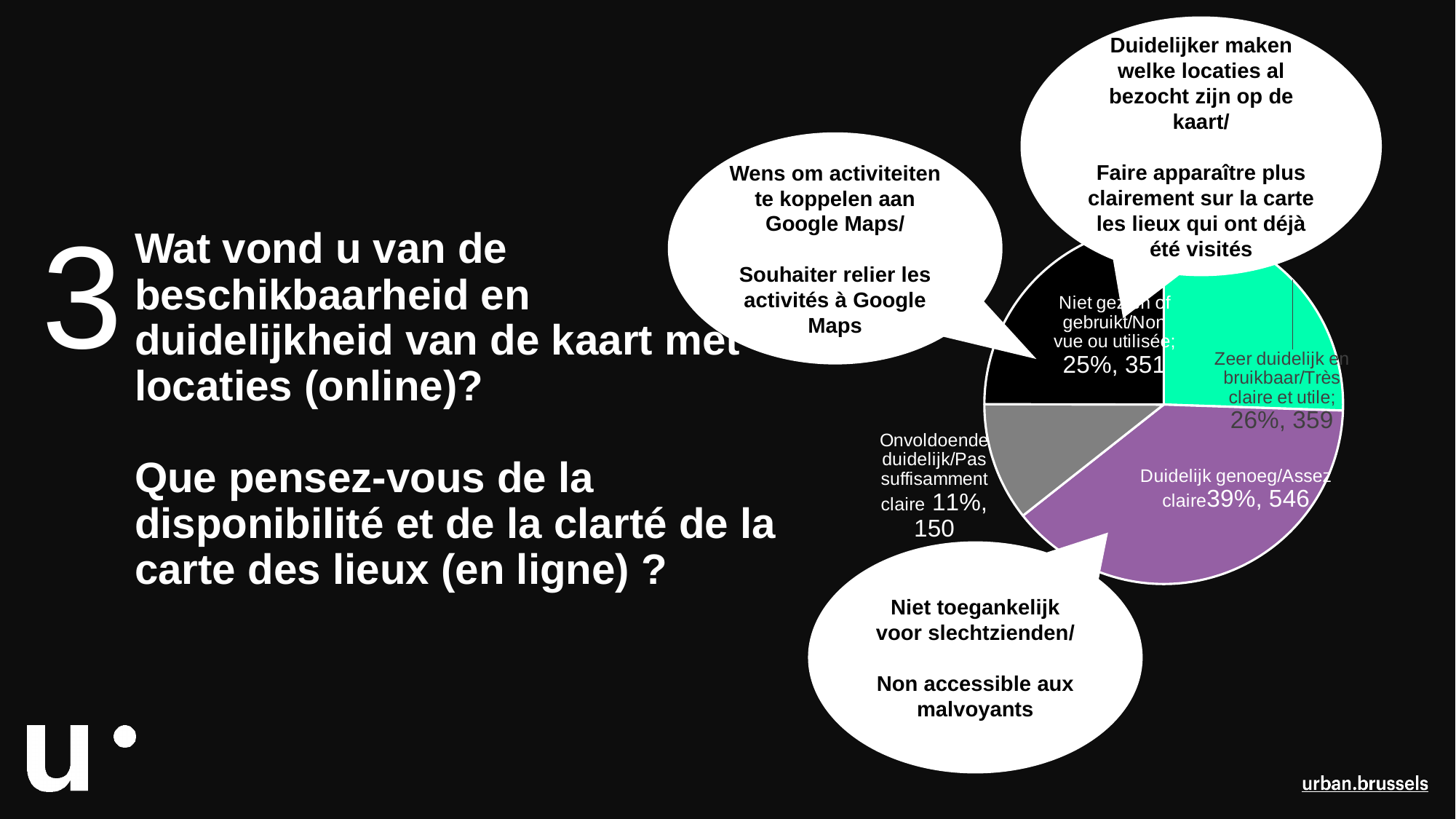
What colour is the slice for 'Duidelijk genoeg/Assez claire'? purple What percentage is shown for 'Zeer duidelijk en bruikbaar/Très claire et utile'? 26% Which slice of the pie chart is the smallest? Onvoldoende duidelijk/Pas suffisamment claire What count is shown for 'Niet gezien of gebruikt/Non vue ou utilisée'? 351 What percentage of the pie is the slice 'Duidelijk genoeg/Assez claire'? 39% What kind of chart is shown on the slide? pie chart What count is shown for 'Onvoldoende duidelijk/Pas suffisamment claire'? 150 What count is shown for the slice 'Duidelijk genoeg/Assez claire'? 546 What is the difference in count between 'Duidelijk genoeg/Assez claire' and 'Onvoldoende duidelijk/Pas suffisamment claire'? 396 How many slices does the pie chart have? 4 What count is shown for 'Zeer duidelijk en bruikbaar/Très claire et utile'? 359 Which slice of the pie chart is the largest? Duidelijk genoeg/Assez claire